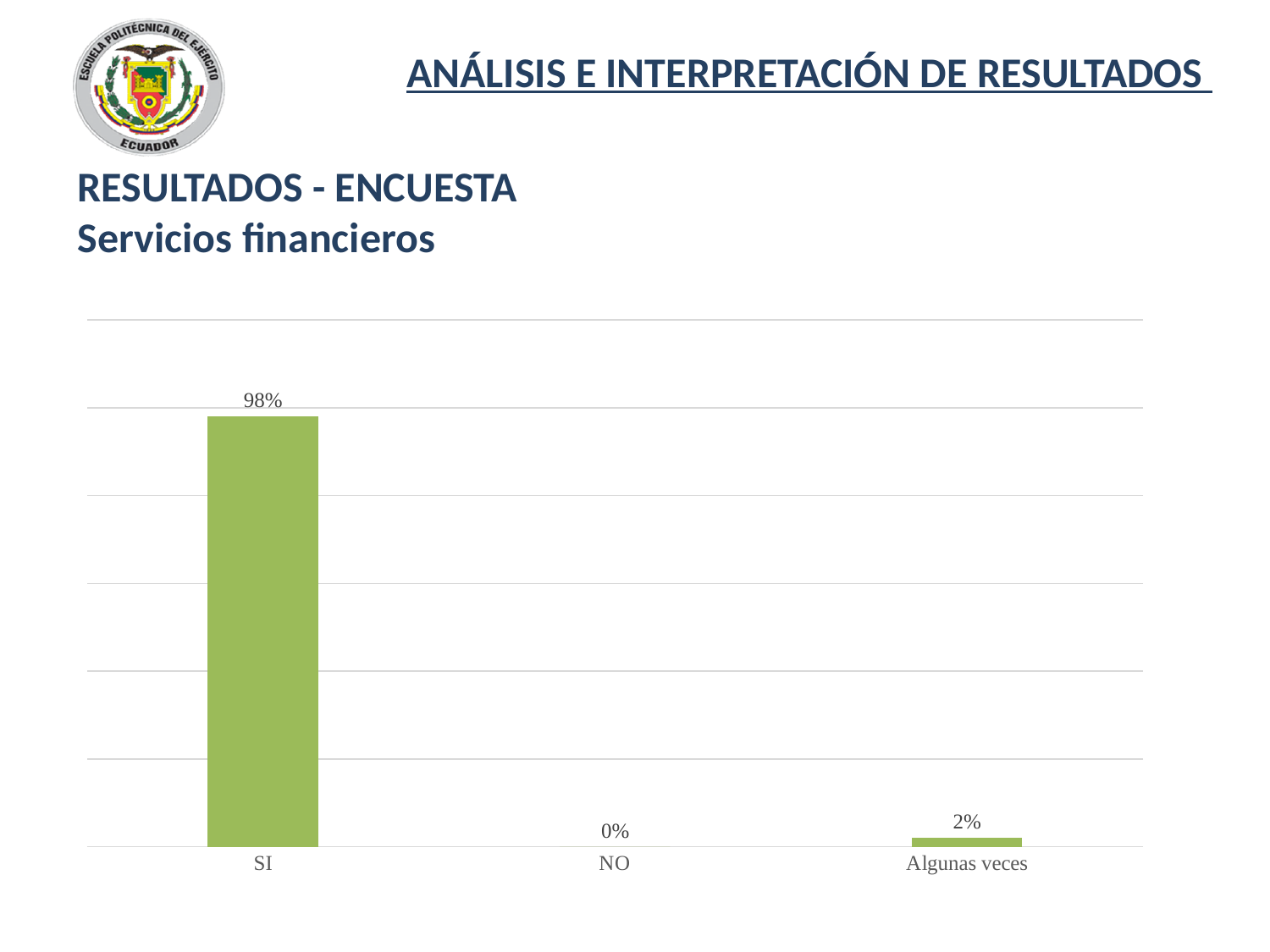
What kind of chart is shown on the slide? bar chart Which category has the lowest value? NO What is the total of the three values shown? 100% Which category has the highest value? SI What is the value for Algunas veces? 2% What is the value for SI? 98% Which is larger, the value for Algunas veces or the value for NO? Algunas veces What is the value for NO? 0% How many categories are shown on the x axis? 3 What colour are the bars in the chart? green What subtitle appears above the chart, below 'RESULTADOS - ENCUESTA'? Servicios financieros What is the difference between the values for SI and Algunas veces? 96%